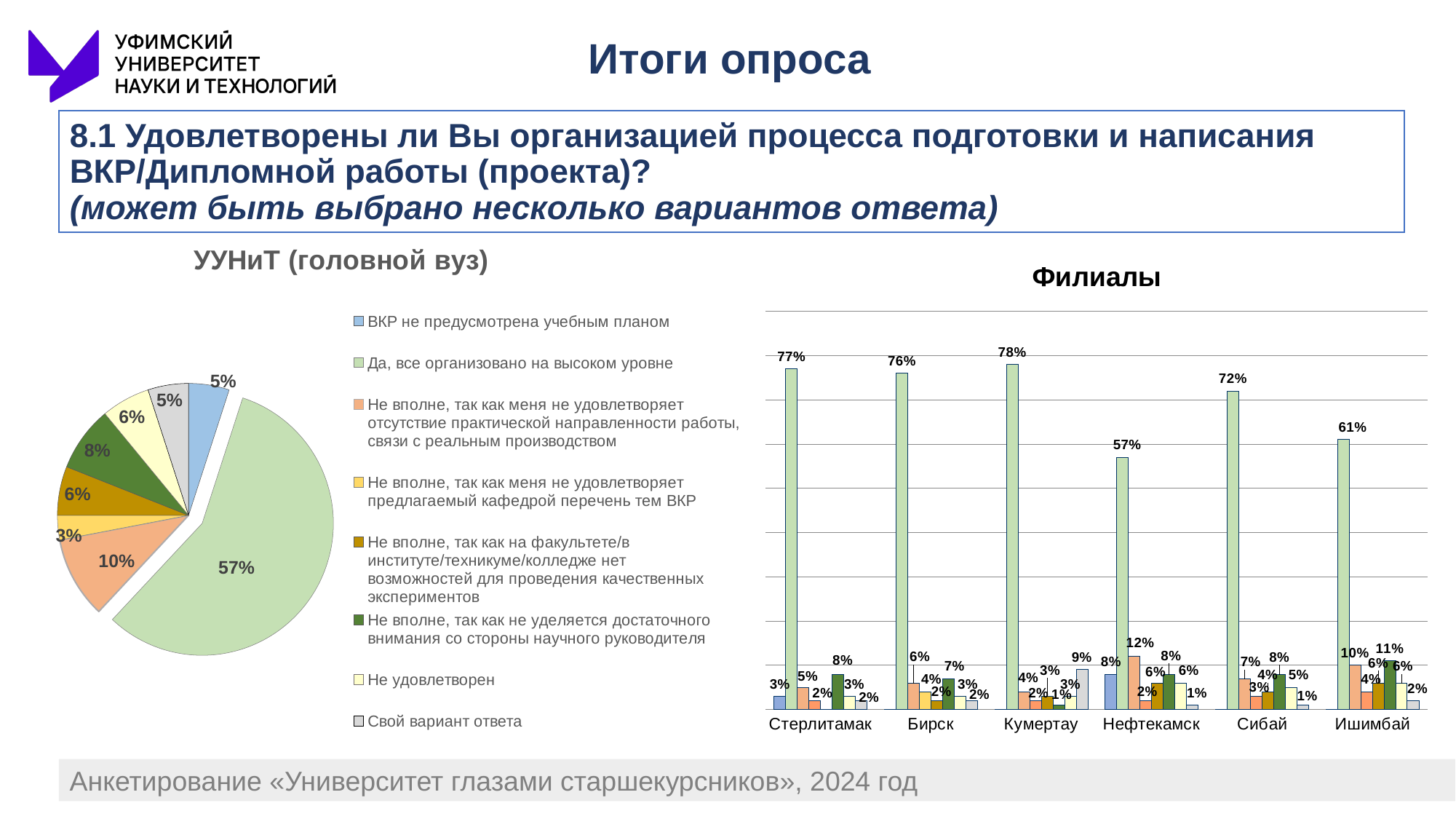
In the pie chart 'УУНиТ (головной вуз)', what share is shown for 'Не вполне, так как меня не удовлетворяет отсутствие практической направленности работы, связи с реальным производством'? 10% In the 'Филиалы' chart, which branch has the lowest value for its tallest (green) bar? Нефтекамск In the 'Филиалы' chart, what is the value of the tallest bar for Нефтекамск? 57% What kind of chart is the 'УУНиТ (головной вуз)' chart? Pie chart How many entries does the legend of the pie chart 'УУНиТ (головной вуз)' list? 8 In the 'Филиалы' chart, what is the difference between the tallest bar for Стерлитамак (77%) and the tallest bar for Ишимбай (61%)? 16% In the pie chart 'УУНиТ (головной вуз)', what share is shown for 'Да, все организовано на высоком уровне'? 57% In the 'Филиалы' chart, which branch has the highest value for its tallest (green) bar? Кумертау What kind of chart is the 'Филиалы' chart? Bar chart How many branches (categories) are shown on the x axis of the 'Филиалы' chart? 6 In the pie chart 'УУНиТ (головной вуз)', which answer option has the largest slice? Да, все организовано на высоком уровне In the 'Филиалы' chart, what is the value of the tallest bar for Кумертау? 78%